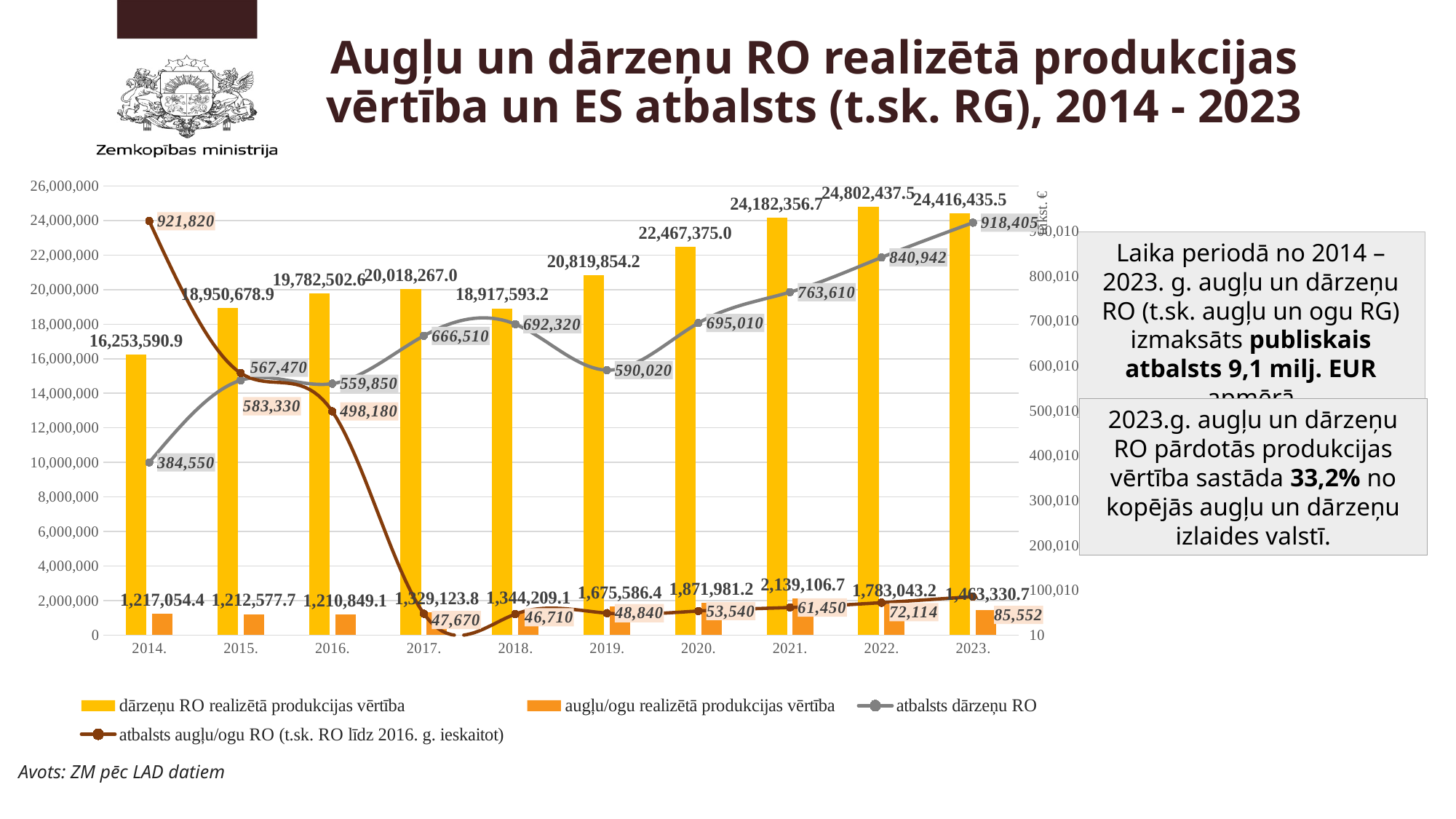
Which is larger in 2014: atbalsts augļu/ogu RO or atbalsts dārzeņu RO? atbalsts augļu/ogu RO What kind of chart is shown on the slide? Combined bar and line chart What is the value of dārzeņu RO realizētā produkcijas vērtība for 2014? 16,253,590.9 What is the difference between atbalsts dārzeņu RO in 2023 and in 2022? 77,463 What is the value of augļu/ogu realizētā produkcijas vērtība for 2021? 2,139,106.7 In which year is dārzeņu RO realizētā produkcijas vērtība highest? 2022. How many years are shown on the x axis of the chart? 10 Does atbalsts augļu/ogu RO rise or fall from 2014 to 2017? Fall In which year is atbalsts dārzeņu RO lowest? 2014. What is the value of atbalsts dārzeņu RO for 2023? 918,405 What is the value of atbalsts augļu/ogu RO for 2017? 47,670 How many series does the chart legend list? 4